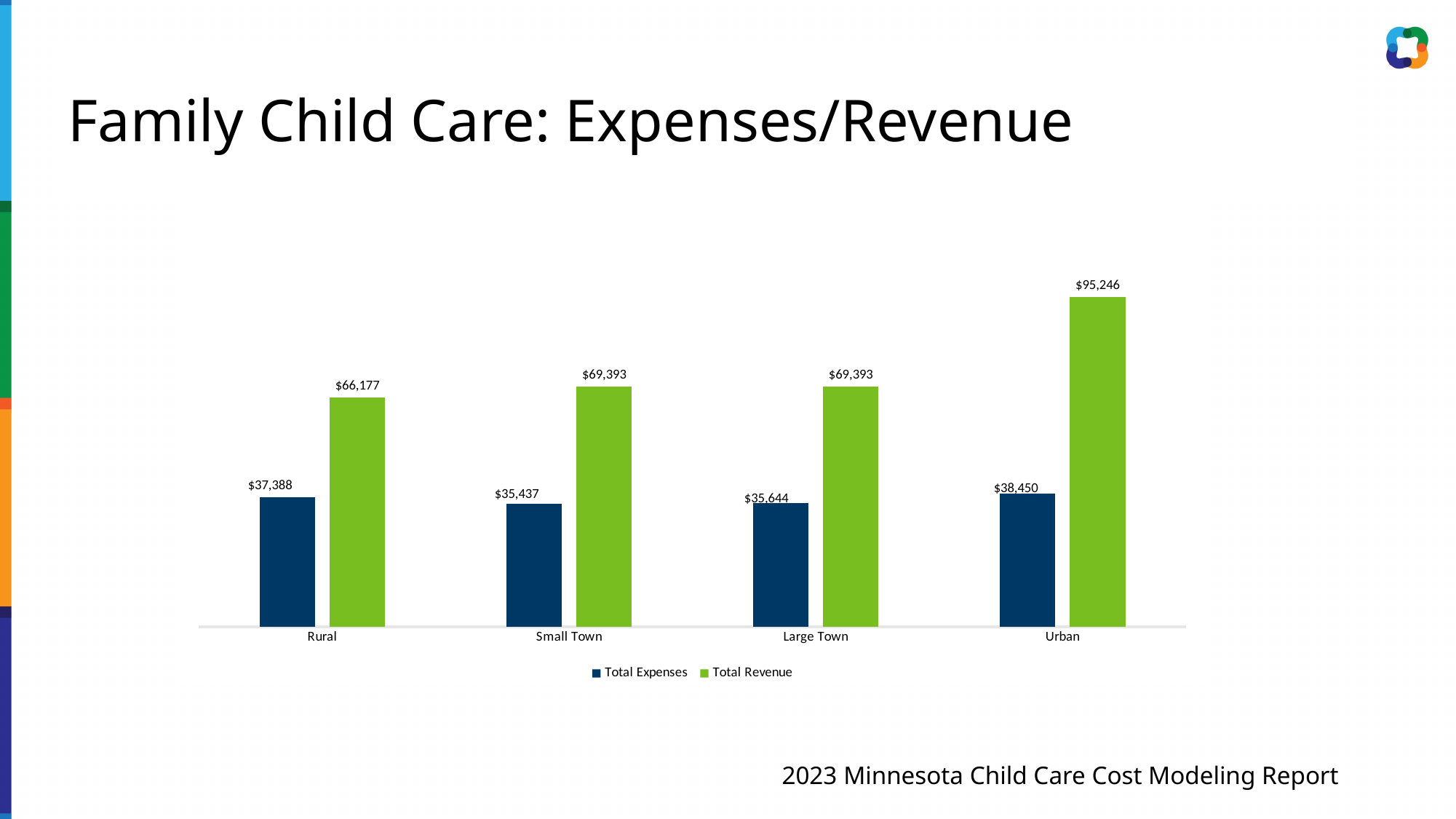
What is the Total Revenue for Urban family child care? $95,246 How many categories are shown on the x axis? 4 What is the Total Expenses value for Large Town? $35,644 What is the difference between Total Revenue and Total Expenses for Urban? $56,796 Which category has the highest Total Revenue? Urban What is the difference between Total Revenue and Total Expenses for Rural? $28,789 Which category has the highest Total Expenses? Urban Which category has the lowest Total Revenue? Rural What is the Total Expenses value for Rural? $37,388 Is Total Revenue for Large Town larger or smaller than Total Revenue for Rural? larger What is the Total Revenue for Small Town? $69,393 What kind of chart is shown on the slide? bar chart